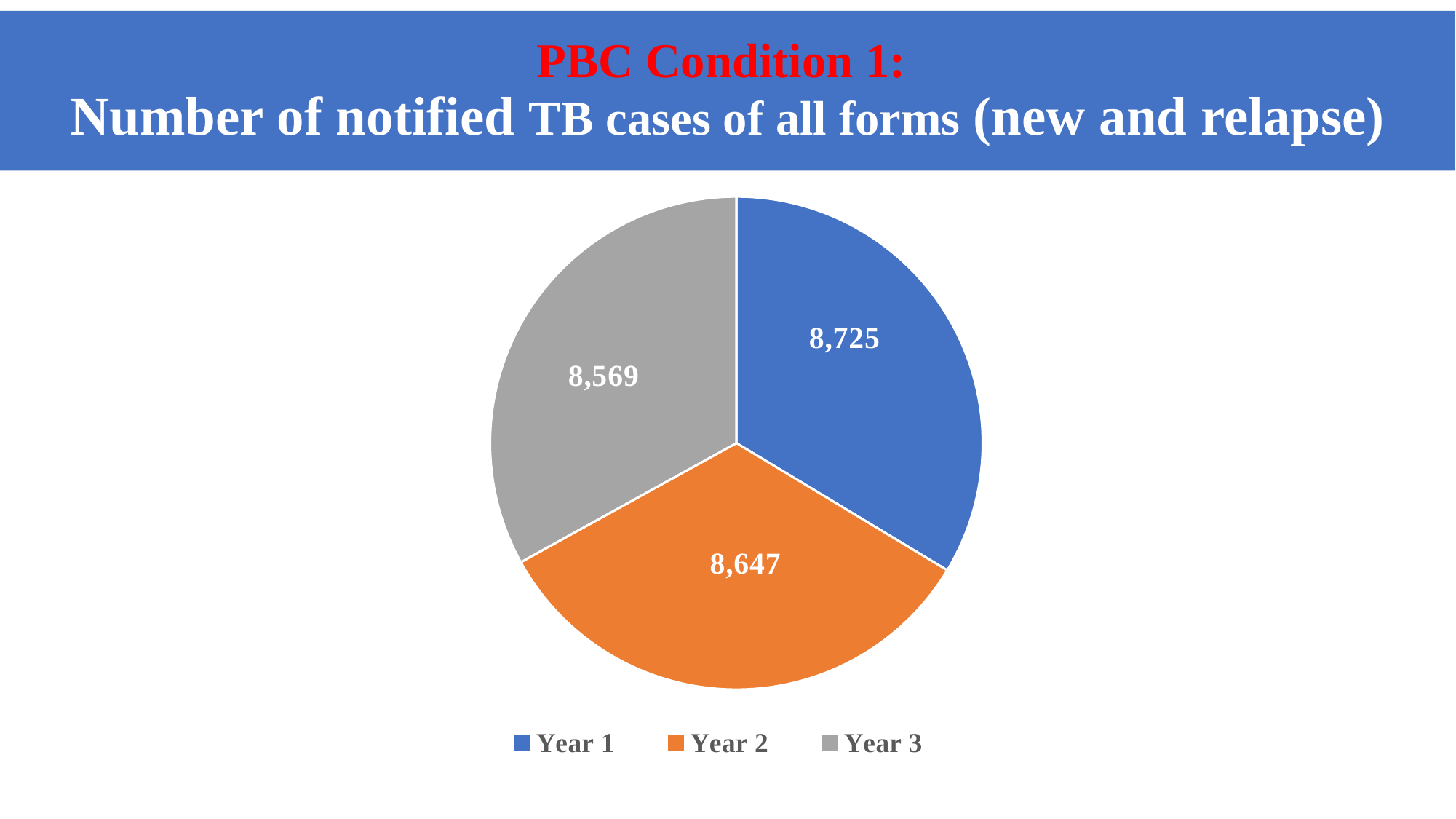
What is the difference between the Year 1 and Year 2 values? 78 Which year has the lowest number of notified TB cases? Year 3 What is the number of notified TB cases for Year 2? 8,647 Do the values rise or fall from Year 1 to Year 3? Fall What is the number of notified TB cases for Year 3? 8,569 Which is larger, the value for Year 2 or the value for Year 3? Year 2 What kind of chart is shown on the slide? Pie chart How many slices does the pie chart have? 3 What is the difference between the Year 1 and Year 3 values? 156 Which year has the highest number of notified TB cases? Year 1 What is the number of notified TB cases for Year 1? 8,725 What colour is the Year 2 slice in the pie chart? Orange